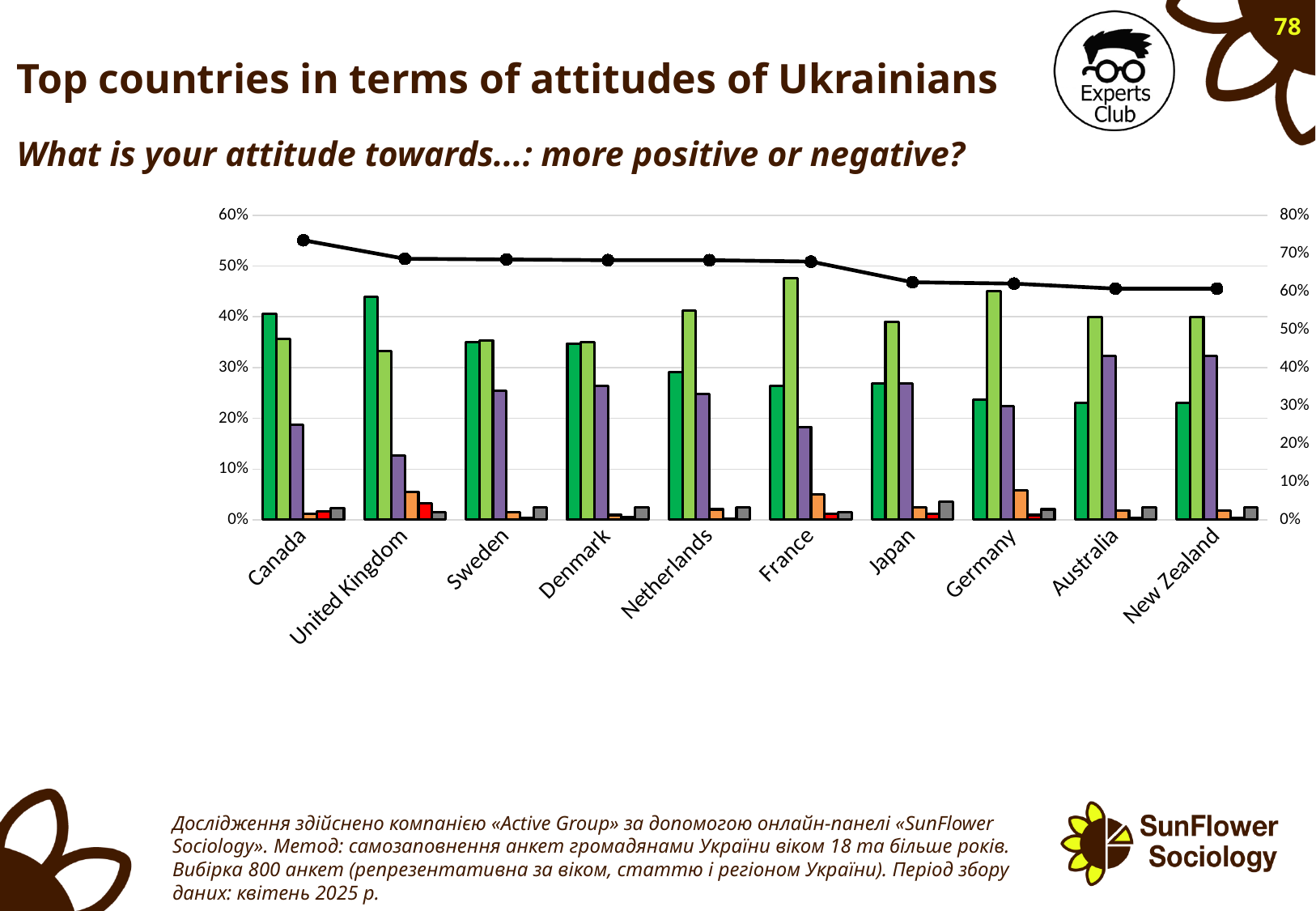
How many countries are shown on the x axis of the chart? 10 Which is larger, the dark green bar for Canada or the dark green bar for Sweden? Canada Is the purple bar for Sweden greater or less than 30%? less Is the black line value for Japan (right axis) greater or less than 70%? less Is the black line value for Canada (right axis) greater or less than 70%? greater Which country has the highest dark green bar? United Kingdom What kind of chart is shown on the slide? bar chart with a line Which country has the highest point on the black line? Canada Which country has the highest light green bar? France Does the black line rise or fall from Canada to New Zealand? fall Which country is listed first on the x axis? Canada